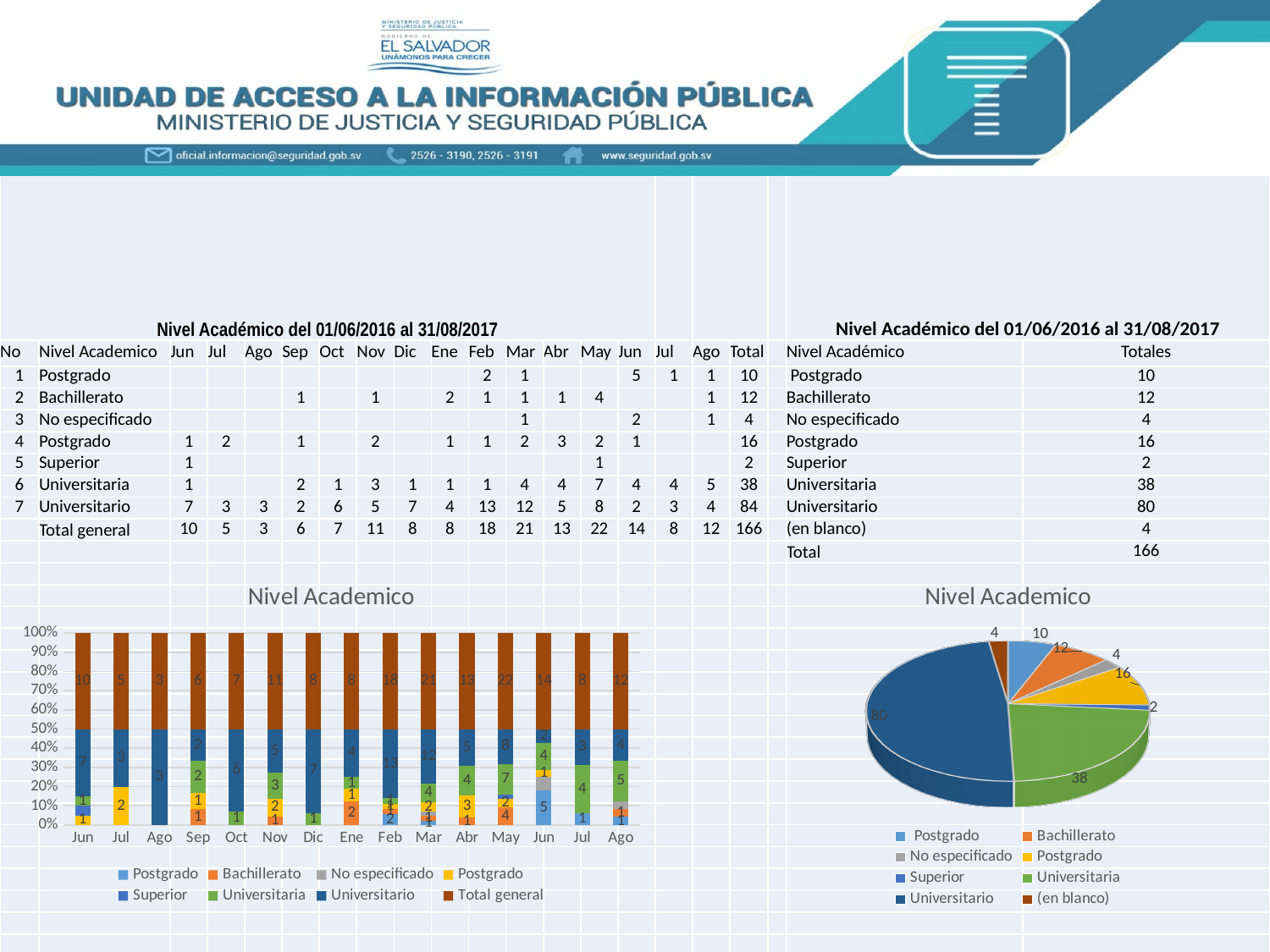
On the bar chart on the left, what is the Universitario value labelled for Feb? 13 On the pie chart on the right, which category has the largest slice? Universitario On the bar chart on the left, what is the Total general value labelled for Mar? 21 What kind of chart is the chart on the left of the slide? Bar chart On the bar chart on the left, what is the difference between the Total general values for May and Jun? 8 What kind of chart is the chart on the right of the slide? Pie chart How many months are shown on the x axis of the bar chart on the left? 15 On the pie chart on the right, which slice is larger, Universitaria or Universitario? Universitario On the bar chart on the left, which month has the highest Total general value? May How many entries does the legend of the pie chart on the right list? 8 On the pie chart on the right, what value is shown for the Universitaria slice? 38 On the pie chart on the right, which category has the smallest slice? Superior